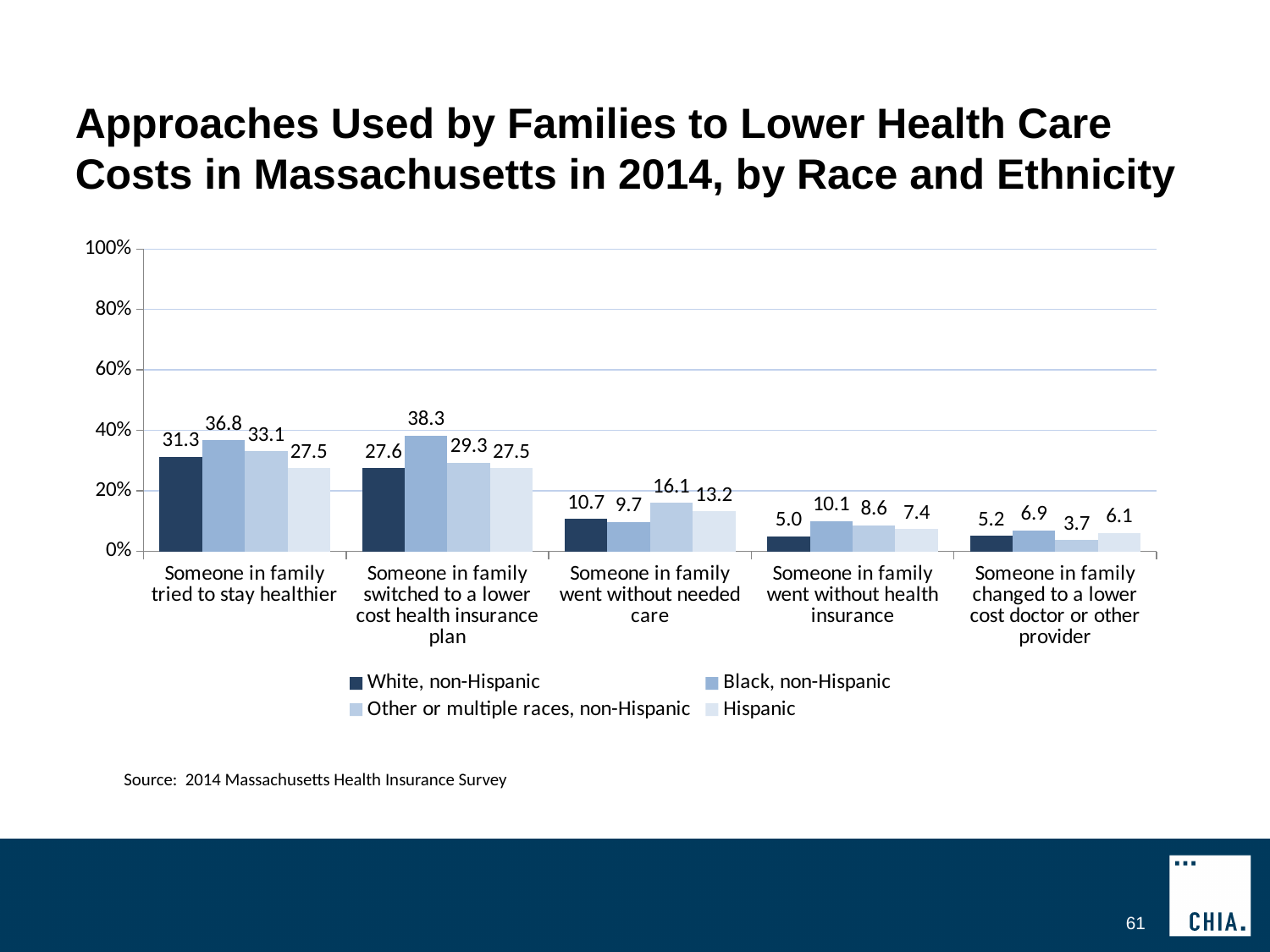
Which is larger in the 'Someone in family went without needed care' category: the White, non-Hispanic value or the Other or multiple races, non-Hispanic value? Other or multiple races, non-Hispanic What is the value for Black, non-Hispanic in the 'Someone in family switched to a lower cost health insurance plan' category? 38.3 Which race/ethnicity group has the highest value in the 'Someone in family went without health insurance' category? Black, non-Hispanic Which race/ethnicity group has the lowest value in the 'Someone in family tried to stay healthier' category? Hispanic What is the value for Hispanic in the 'Someone in family went without needed care' category? 13.2 What is the value for White, non-Hispanic in the 'Someone in family tried to stay healthier' category? 31.3 What is the difference between the Black, non-Hispanic and White, non-Hispanic values in the 'Someone in family switched to a lower cost health insurance plan' category? 10.7 How many series does the legend list? 4 What is the value for Other or multiple races, non-Hispanic in the 'Someone in family changed to a lower cost doctor or other provider' category? 3.7 What kind of chart is shown on the slide? Bar chart What is the source cited below the chart? 2014 Massachusetts Health Insurance Survey How many approach categories are shown on the x axis? 5